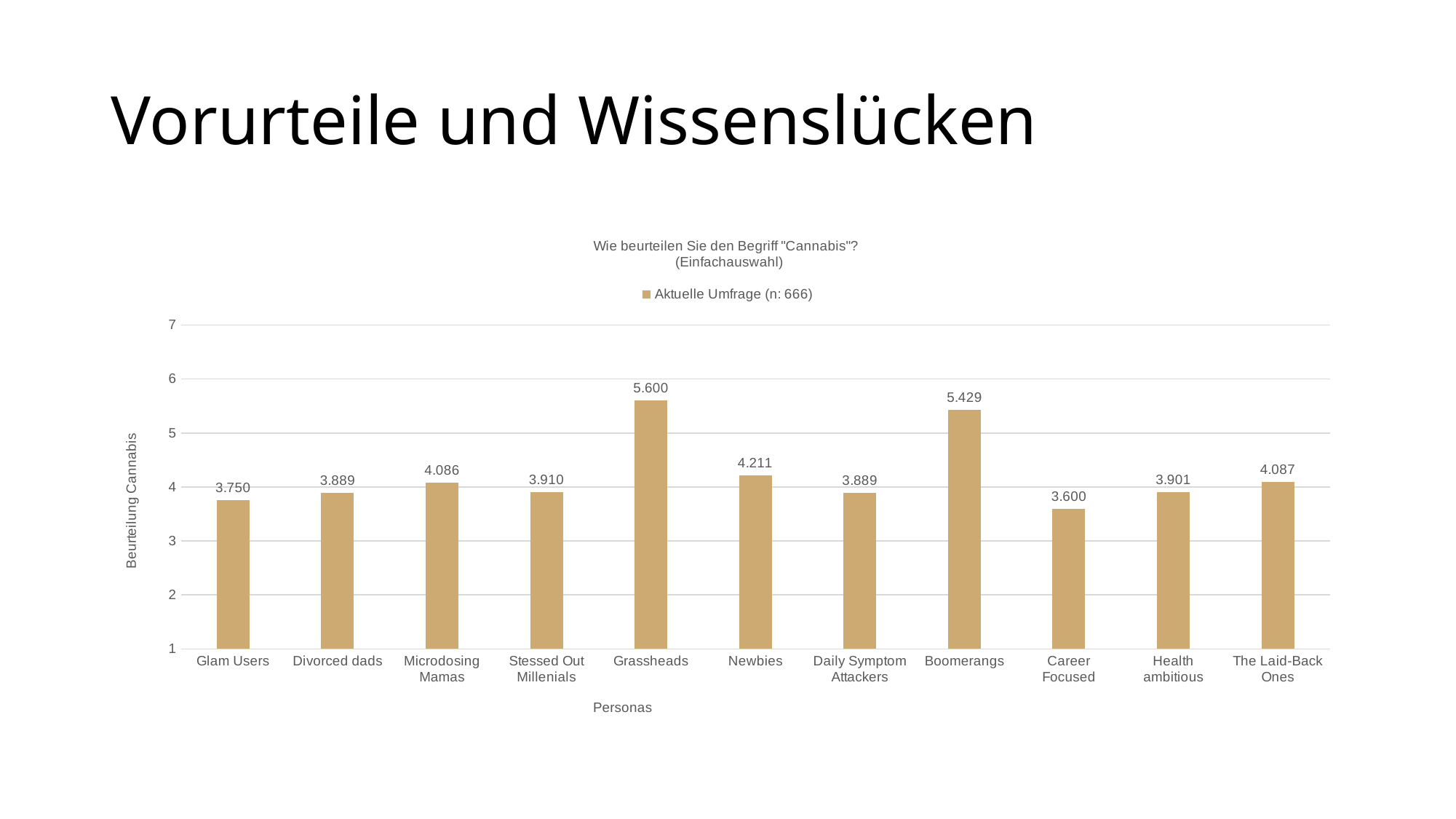
What is the difference between the values for Grassheads and Boomerangs? 0.171 What kind of chart is shown? Bar chart Which persona has the highest value? Grassheads How many personas are shown on the x axis? 11 What is the value for Career Focused? 3.600 Which is larger, the value for Newbies or the value for Microdosing Mamas? Newbies Which persona has the lowest value? Career Focused What is the legend entry of the chart? Aktuelle Umfrage (n: 666) What is the value for Newbies? 4.211 How many series does the legend list? 1 What is the value for Grassheads? 5.600 What is the value for Boomerangs? 5.429